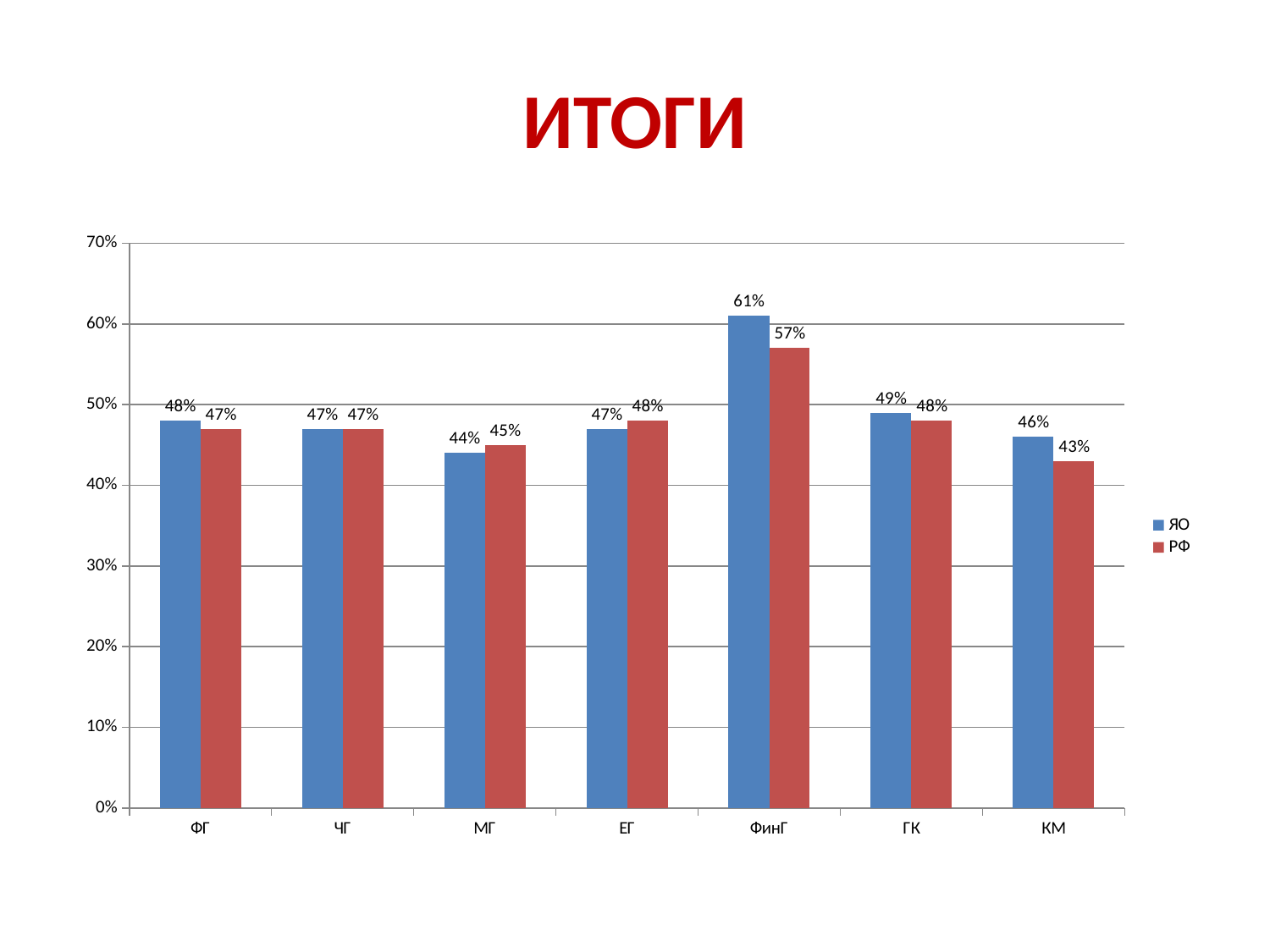
What is the difference between the ЯО and РФ values in the КМ category? 3% Which category has the highest value for the ЯО series? ФинГ Which category has the lowest value for the РФ series? КМ What kind of chart is shown on the slide? bar chart What is the value for РФ in the КМ category? 43% How many series does the legend list? 2 What is the difference between the ЯО and РФ values in the ФинГ category? 4% How many categories are shown on the x axis? 7 What is the value for ЯО in the МГ category? 44% Is the value for ЯО in the ФинГ category greater or less than 60%? greater What is the value for ЯО in the ФинГ category? 61% Which is larger in the ЕГ category, the ЯО value or the РФ value? РФ